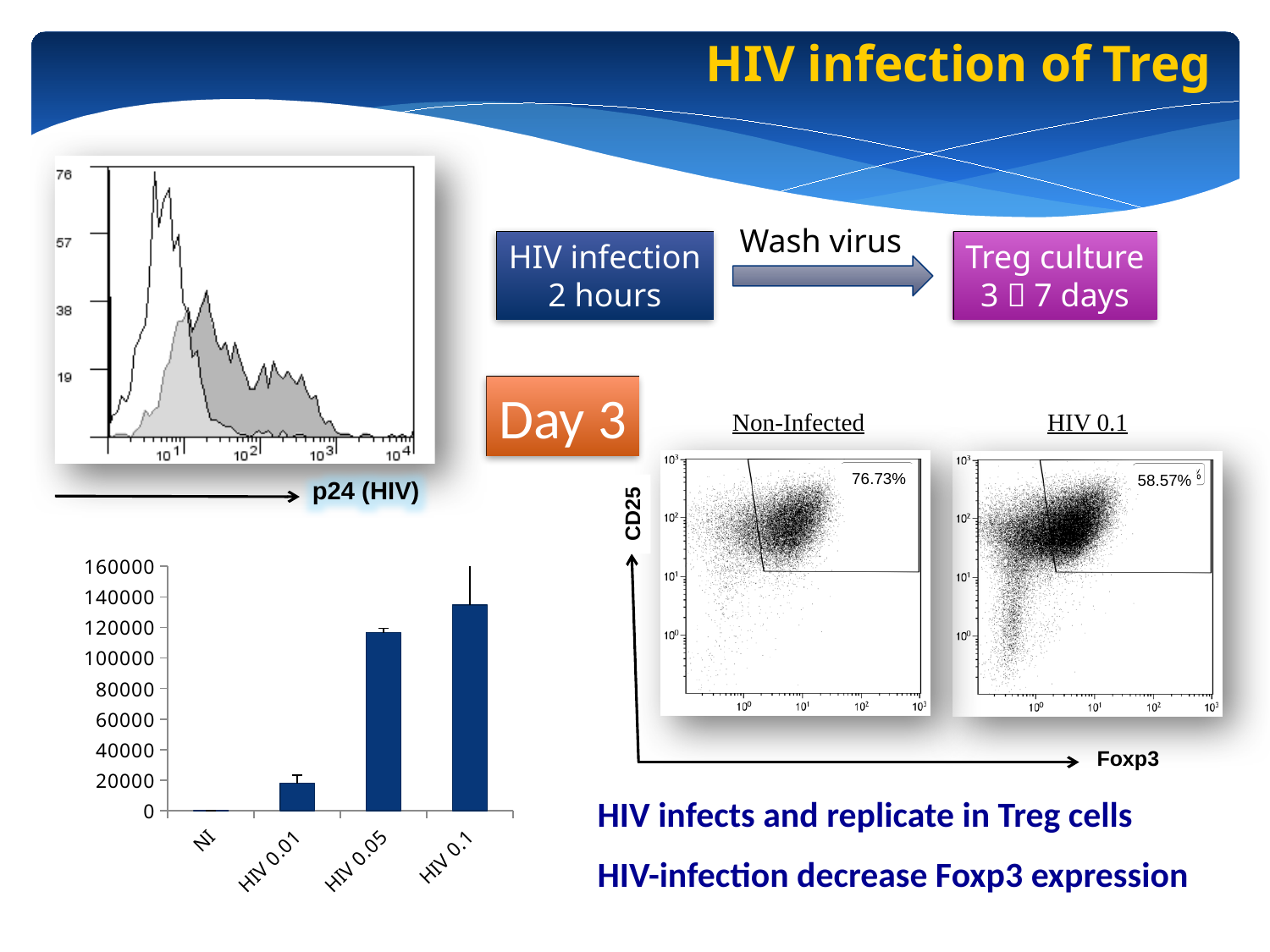
In the Day 3 dot plots, what percentage is shown in the gate of the HIV 0.1 plot? 58.57% In the bottom-left bar chart, which is larger, the bar for HIV 0.01 or the bar for HIV 0.05? HIV 0.05 How many categories are shown on the x axis of the bottom-left bar chart? 4 In the bottom-left bar chart, which category has the lowest bar? NI What kind of chart is the chart in the bottom-left of the slide? bar chart In the bottom-left bar chart, is the value for HIV 0.01 greater or less than 40000? less In the Day 3 dot plots, what percentage is shown in the gate of the Non-Infected plot? 76.73% In the bottom-left bar chart, which category has the highest bar? HIV 0.1 In the bottom-left bar chart, is the value for HIV 0.1 greater or less than 120000? greater In the bottom-left bar chart, do the bar values rise or fall from NI to HIV 0.1 along the x axis? rise In the bottom-left bar chart, is the value for HIV 0.05 greater or less than 100000? greater In the Day 3 dot plots, what is the difference between the gated percentage for Non-Infected and for HIV 0.1? 18.16%